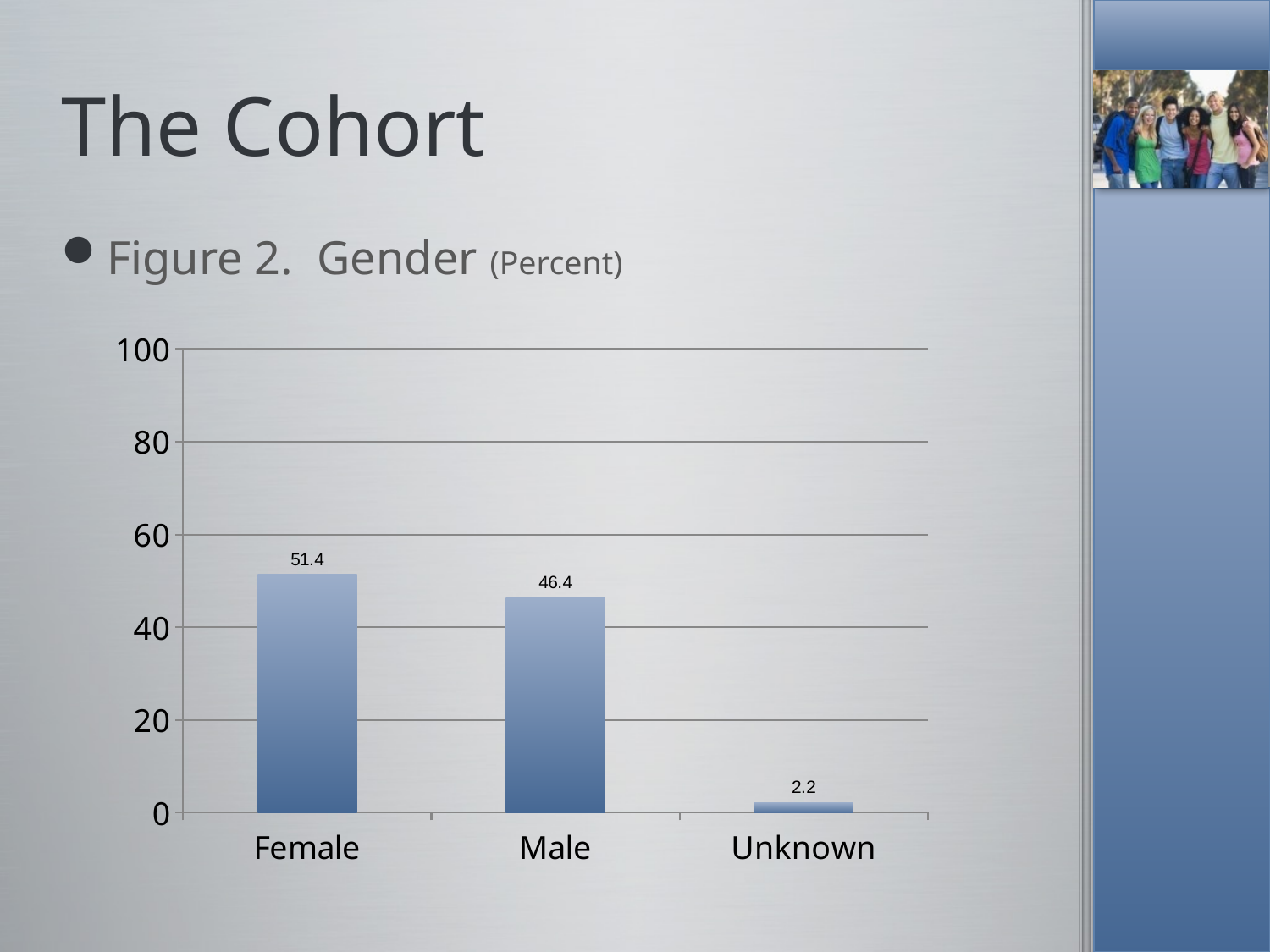
What kind of chart is shown on the slide? bar chart What is the difference between the Female and Male values? 5.0 What is the title of the figure shown on the slide? Figure 2. Gender (Percent) What is the value for Male? 46.4 What is the value for Unknown? 2.2 Which category has the lowest value? Unknown What is the difference between the Male and Unknown values? 44.2 What is the value for Female? 51.4 Is the value for Male greater or less than 40? greater How many categories are shown on the x axis? 3 Which is larger, the value for Female or the value for Male? Female Which category has the highest value? Female